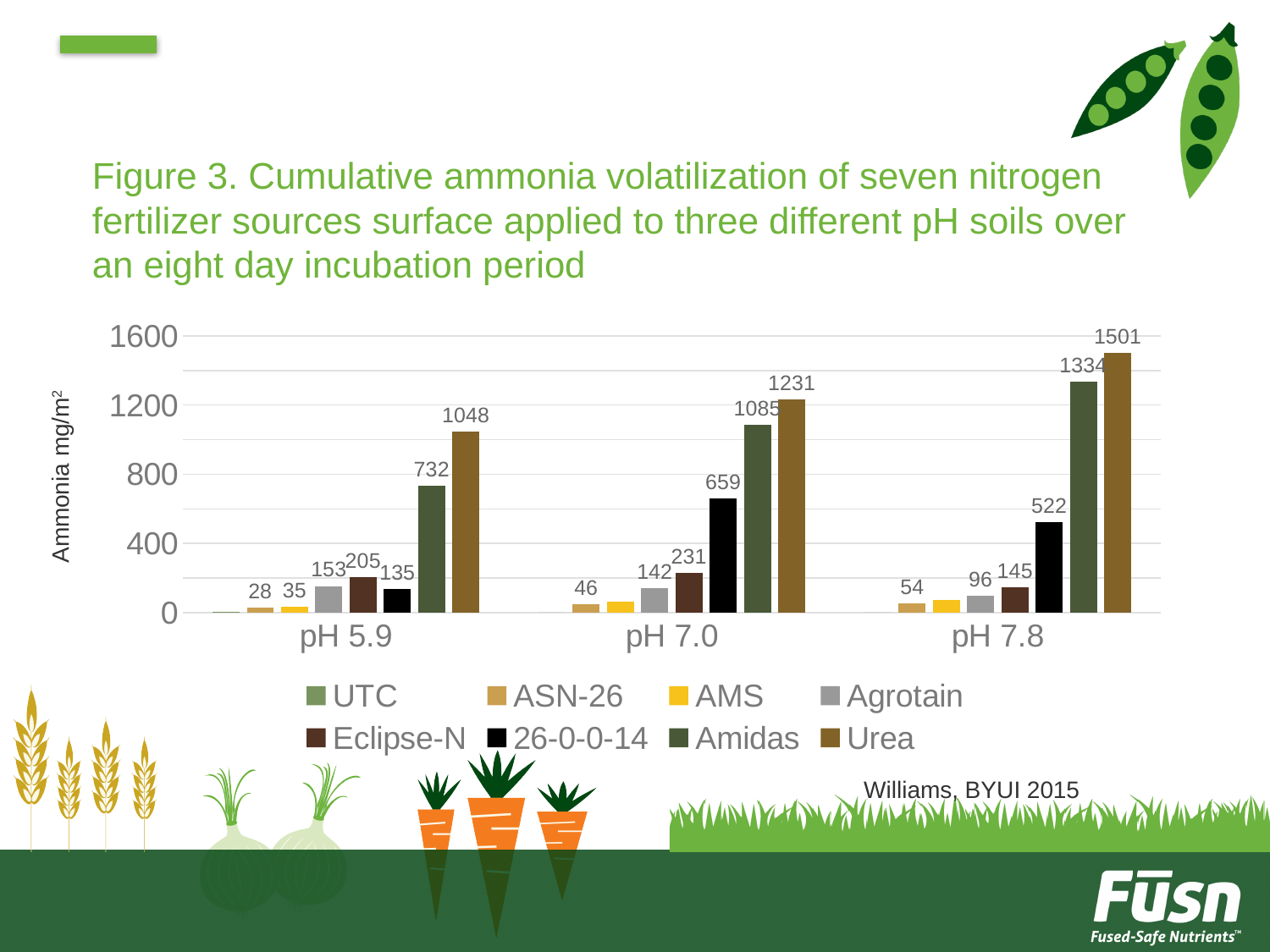
What kind of chart is shown on the slide? bar chart Which fertilizer source has the highest ammonia volatilization at pH 7.0? Urea How many series does the legend list? 8 What is the value for Urea at pH 7.8? 1501 Do the Urea values rise or fall as soil pH increases from 5.9 to 7.8? rise At pH 5.9, which is larger: Eclipse-N or Agrotain? Eclipse-N What is the difference between the Urea and Amidas values at pH 7.8? 167 Which labelled fertilizer source has the lowest value at pH 5.9? ASN-26 What is the value for 26-0-0-14 at pH 7.0? 659 What is the value for Agrotain at pH 7.8? 96 Is the value for AMS at pH 7.0 greater or less than 400? less What is the value for Amidas at pH 5.9? 732